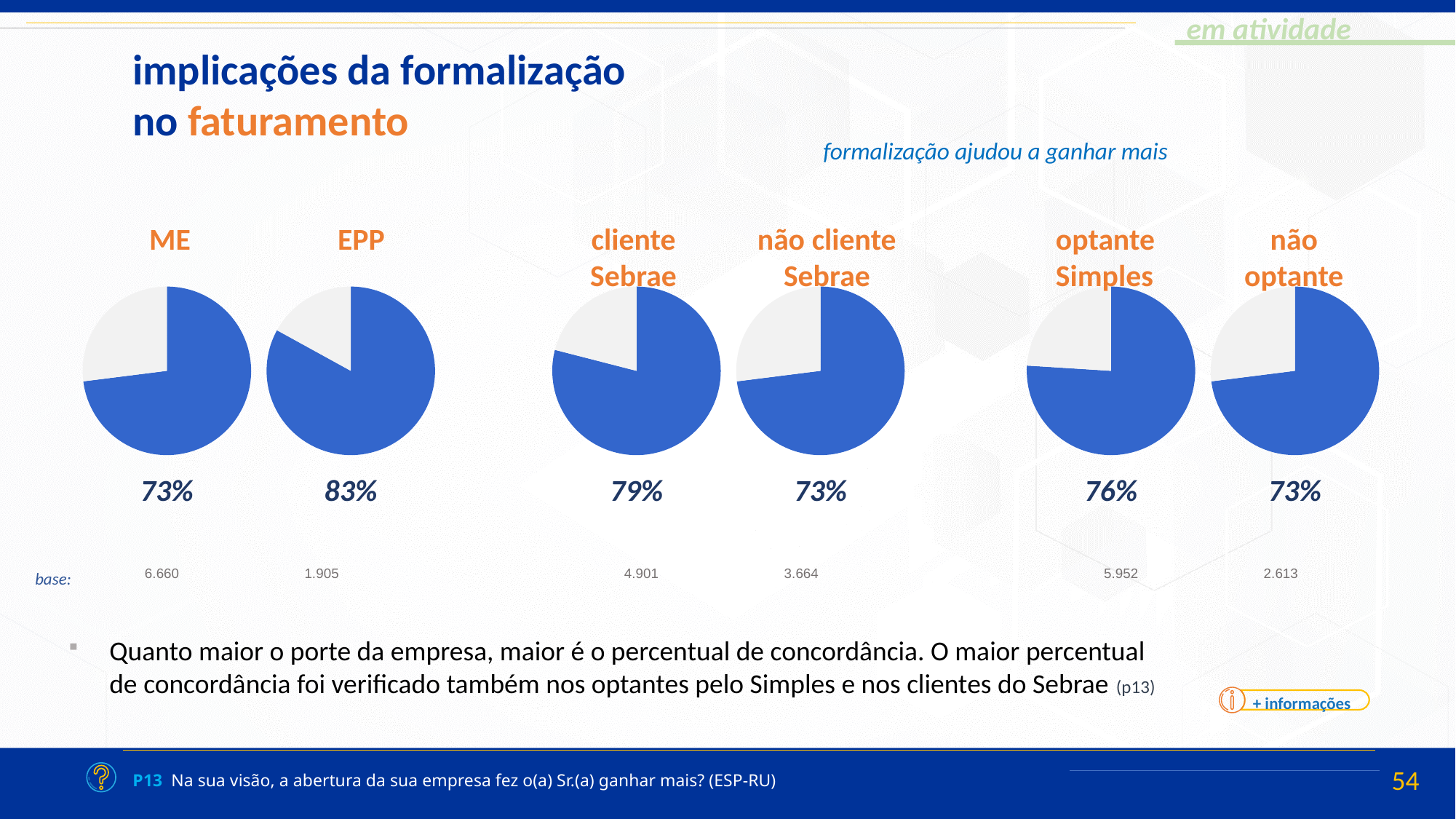
Which of the six pie charts shows the highest percentage? EPP How many pie charts are shown on the slide? 6 What is the base (sample size) shown under the 'não cliente Sebrae' pie chart? 3.664 What is the difference between the EPP percentage and the ME percentage? 10 percentage points What is the difference between the 'optante Simples' and 'não optante' percentages? 3 percentage points What percentage is shown for the EPP pie chart? 83% What type of chart is used to show the percentages on this slide? Pie chart What percentage is shown for the 'optante Simples' pie chart? 76% Which is larger, the percentage for 'cliente Sebrae' or for 'não cliente Sebrae'? cliente Sebrae What is the base (sample size) shown under the ME pie chart? 6.660 What percentage is shown for the ME pie chart? 73% What percentage is shown for the 'cliente Sebrae' pie chart? 79%